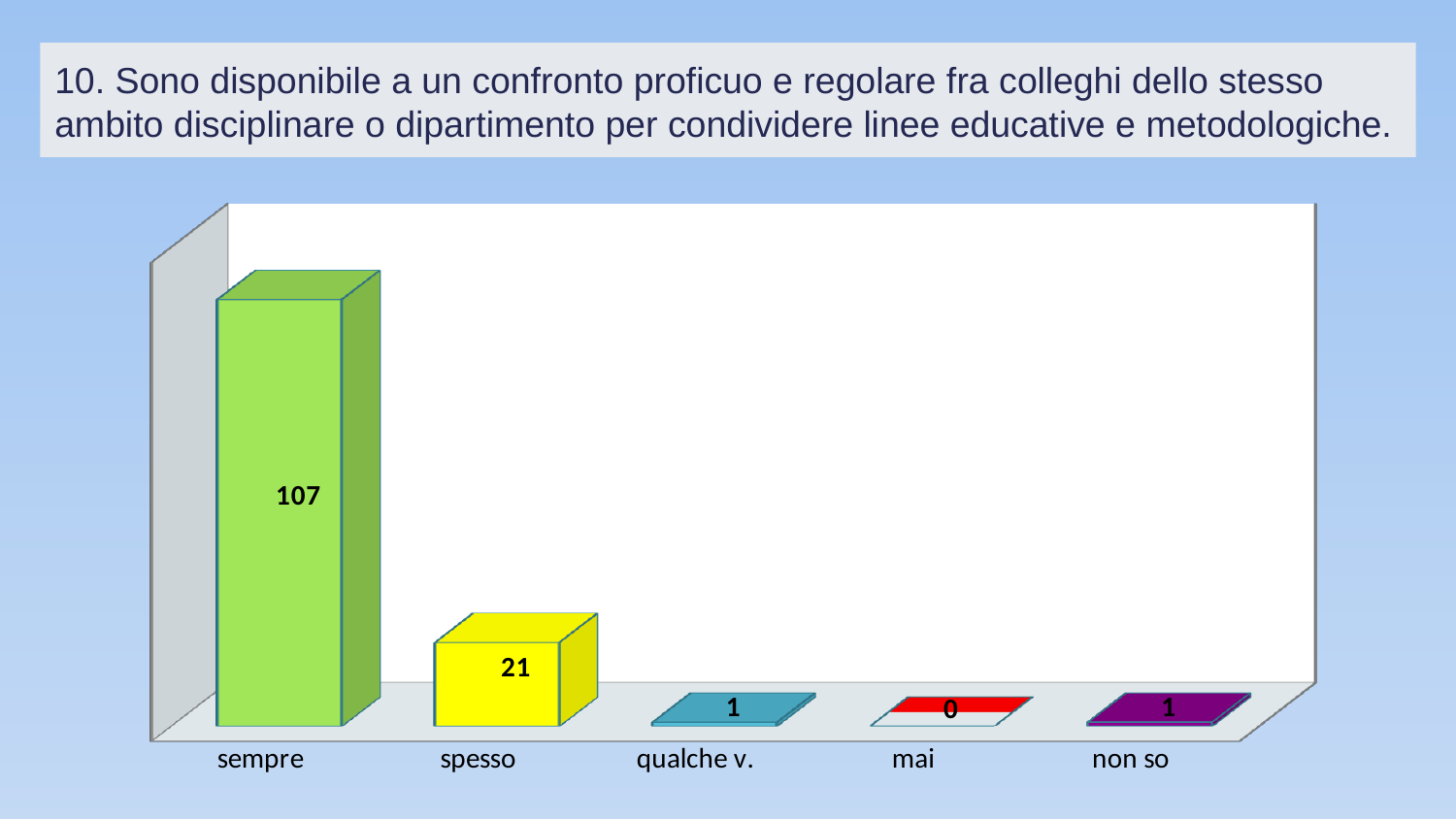
What is the value for "mai"? 0 What kind of chart is shown on the slide? bar chart What is the difference between the values for "sempre" and "spesso"? 86 How many categories are shown on the x axis? 5 Which is larger, the value for "spesso" or the value for "qualche v."? spesso What is the value for "non so"? 1 What is the total of all the values shown in the chart? 130 Which category has the highest value? sempre What is the value for "qualche v."? 1 What is the value for "spesso"? 21 Which category has the lowest value? mai What is the value for "sempre"? 107